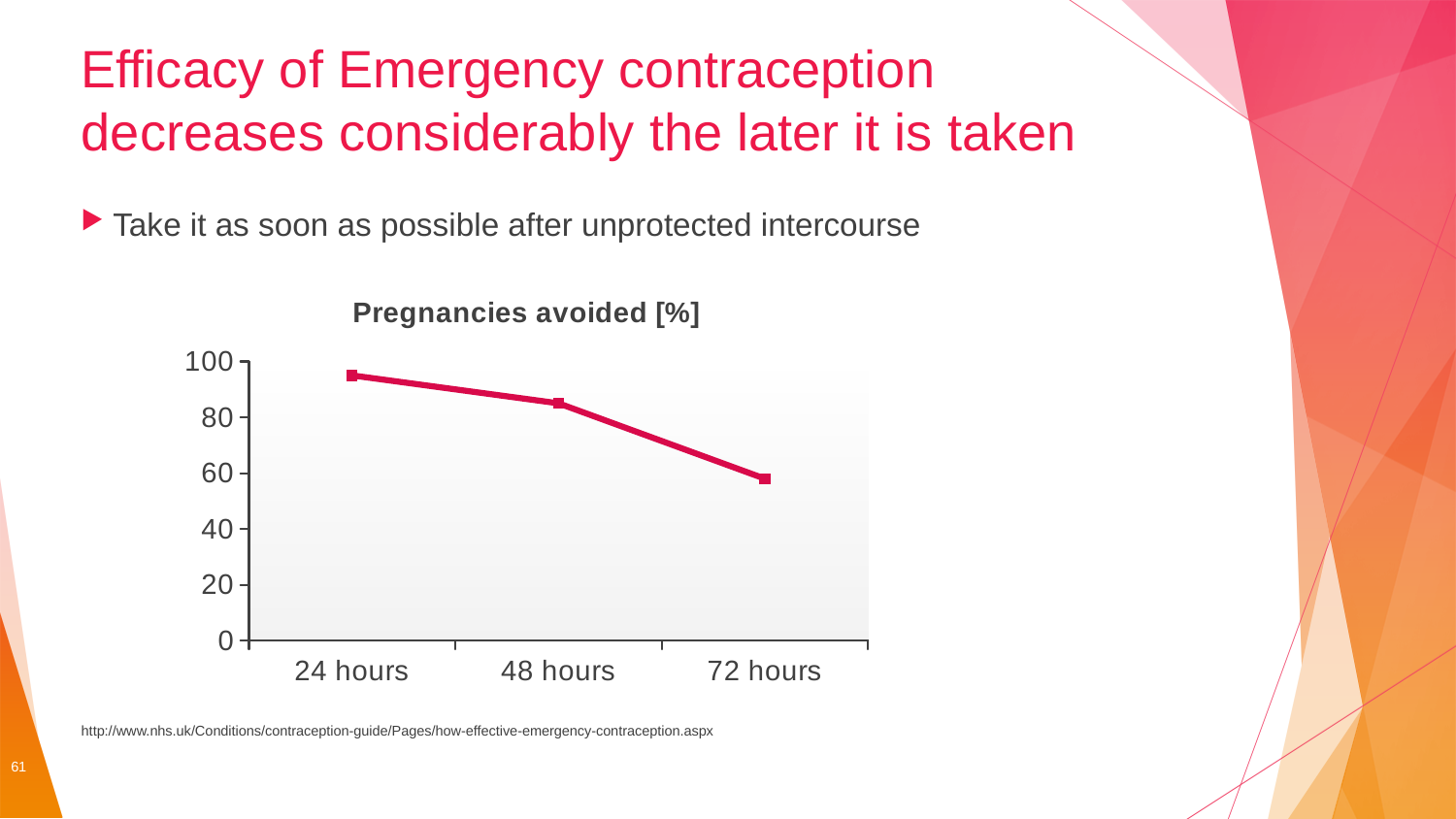
Which time point has the lowest percentage of pregnancies avoided? 72 hours Which time point has the highest percentage of pregnancies avoided? 24 hours Is the value for 48 hours greater or less than 60? greater Which is larger, the value for 24 hours or the value for 72 hours? 24 hours What is the title of the chart? Pregnancies avoided [%] Do the values rise or fall as time after intercourse increases along the x axis? fall Is the value for 24 hours greater or less than 80? greater What kind of chart is shown on the slide? line chart Is the value for 72 hours greater or less than 80? less What is the highest value shown on the y axis? 100 How many data points are plotted on the chart? 3